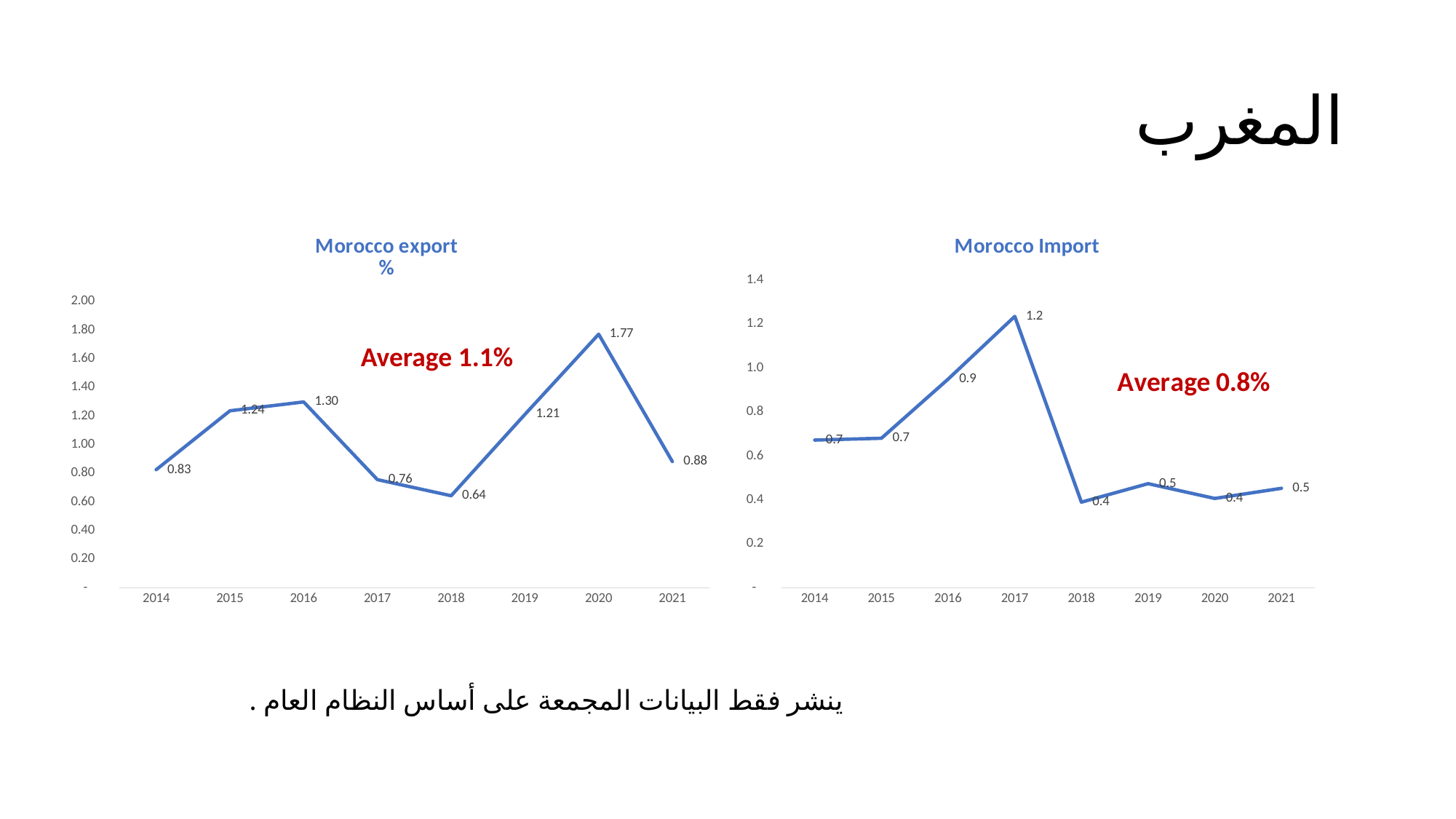
In the Morocco Import chart, which year has the highest value? 2017 In the Morocco export % chart, which year has the lowest value? 2018 In the Morocco export % chart, what is the difference between the 2020 value and the 2021 value? 0.89 In the Morocco Import chart, do the values rise or fall from 2017 to 2018? fall What average is stated on the Morocco Import chart? Average 0.8% In the Morocco export % chart, which year has the highest value? 2020 In the Morocco Import chart, what is the value for 2017? 1.2 What kind of chart is the Morocco Import chart? line chart In the Morocco Import chart, is the value for 2016 larger or smaller than the value for 2019? larger In the Morocco export % chart, how many years are plotted? 8 In the Morocco export % chart, what is the value for 2018? 0.64 In the Morocco export % chart, what is the value for 2020? 1.77